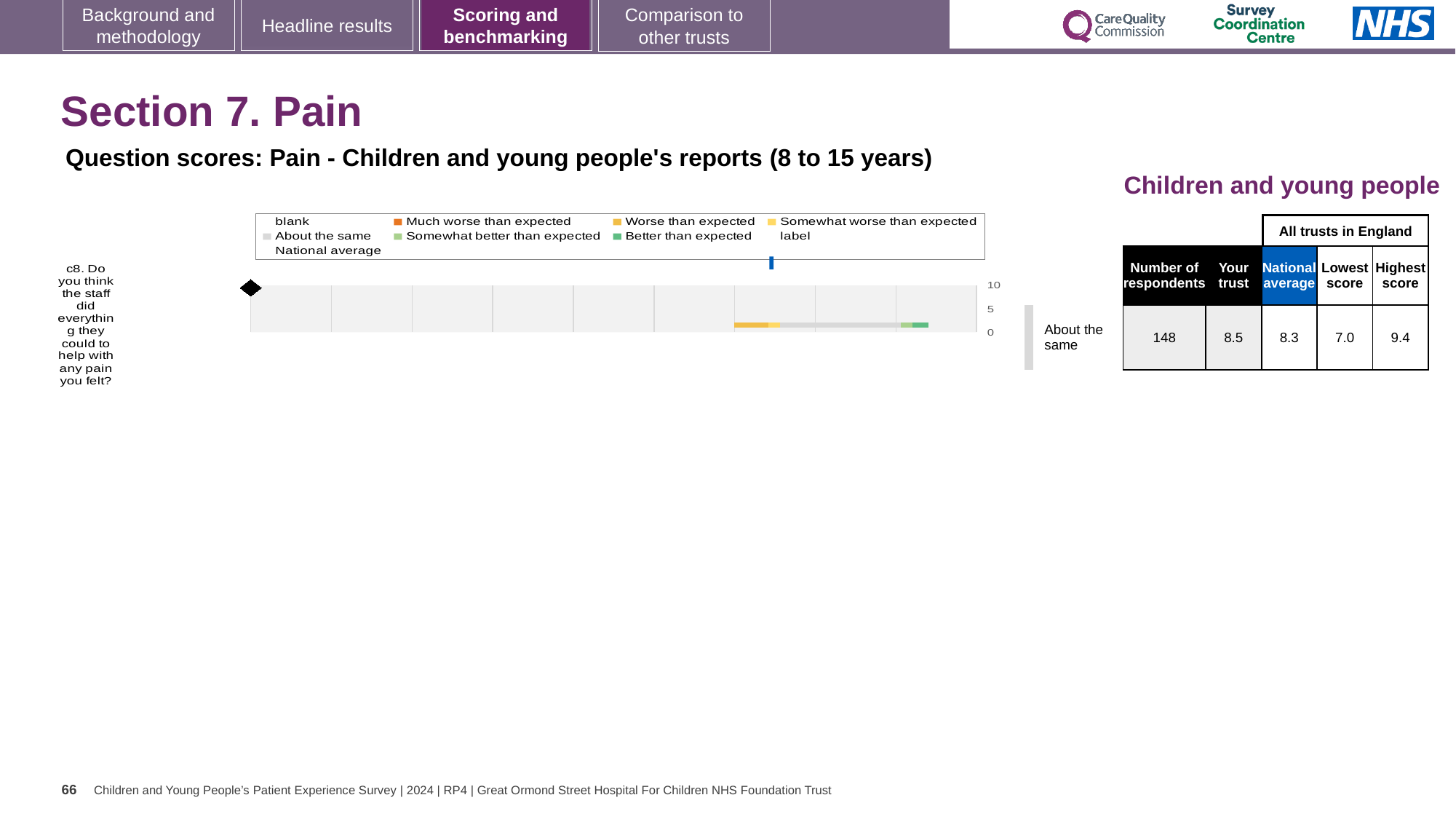
What is the difference between the highest and lowest trust scores for question c8? 2.4 What is the national average score for question c8? 8.3 How many survey questions are plotted in the chart? 1 What kind of chart is shown on the slide? bar chart Which is larger for question c8: the 'Your trust' score or the national average? Your trust What is the 'Your trust' score for question c8 (Do you think the staff did everything they could to help with any pain you felt?)? 8.5 Which benchmark category is the trust's result for question c8 placed in? About the same What is the highest score among all trusts in England for question c8? 9.4 What is the highest tick value shown on the chart's score axis? 10 How many respondents answered question c8? 148 By how much does the 'Your trust' score for c8 exceed the national average? 0.2 What is the lowest score among all trusts in England for question c8? 7.0